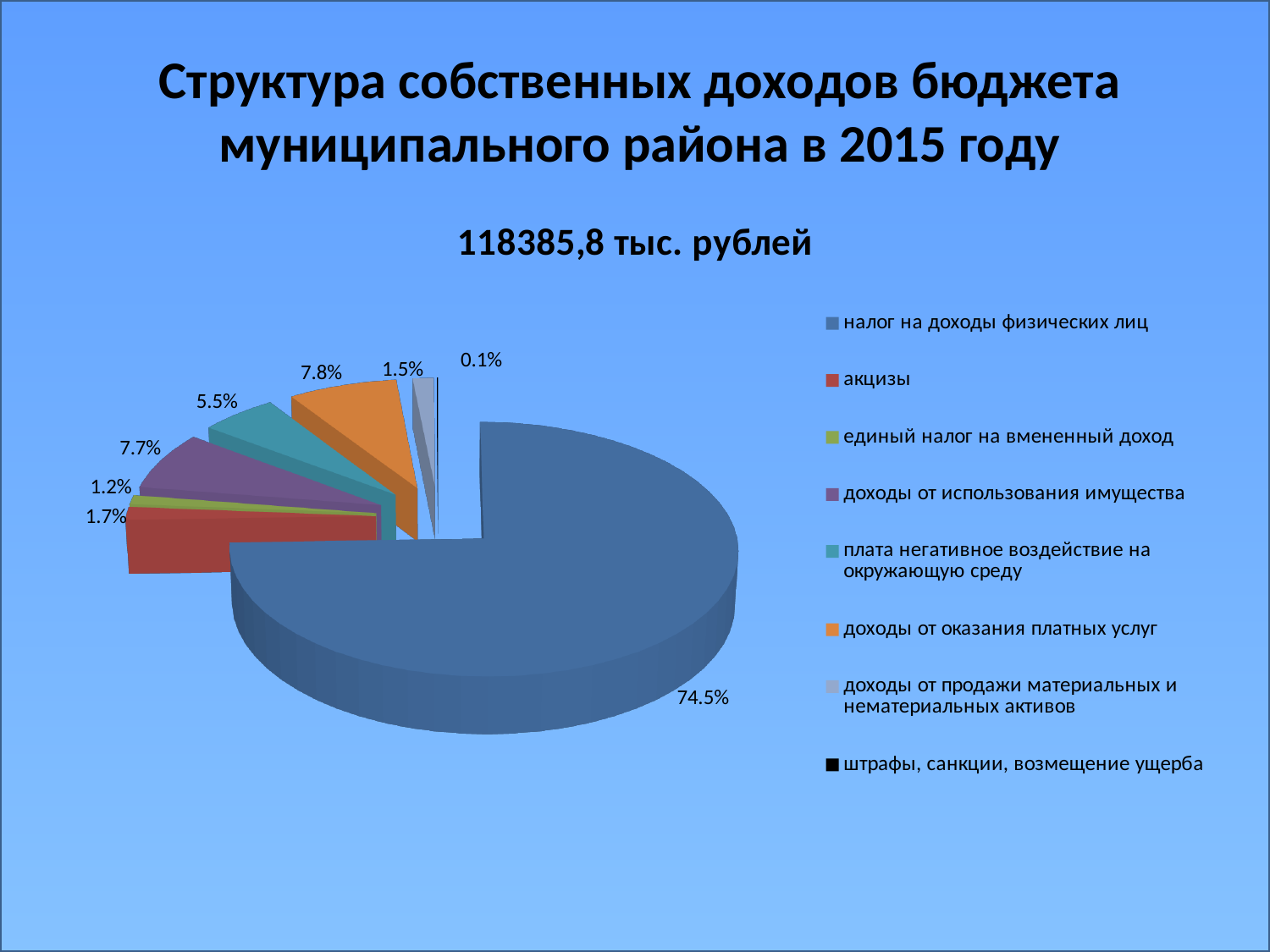
What share of the pie does налог на доходы физических лиц hold? 74.5% What percentage is shown for доходы от оказания платных услуг? 7.8% What is the difference in percentage points between доходы от оказания платных услуг and плата негативное воздействие на окружающую среду? 2.3 What percentage is shown for акцизы? 1.7% Which category has the smallest share of the pie? штрафы, санкции, возмещение ущерба What percentage is shown for плата негативное воздействие на окружающую среду? 5.5% Which category has the largest share of the pie? налог на доходы физических лиц How many categories does the legend list? 8 What total amount in thousand rubles is stated above the chart? 118385,8 тыс. рублей What kind of chart is shown on the slide? pie chart Which is larger: the share for акцизы or the share for единый налог на вмененный доход? акцизы What percentage is shown for доходы от использования имущества? 7.7%